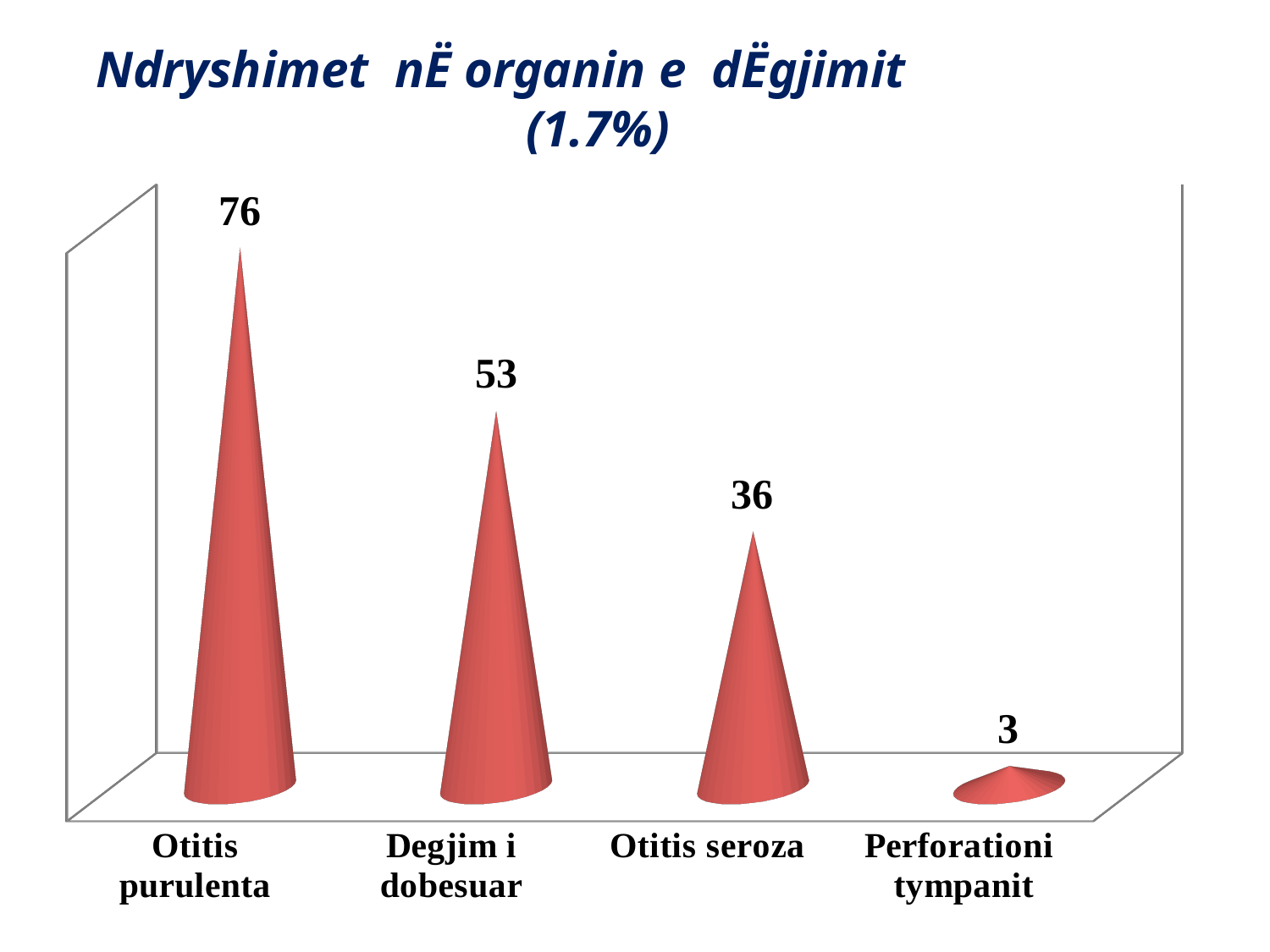
What is the difference between the values for Otitis seroza and Perforationi tympanit? 33 Do the values rise or fall from left to right across the categories? Fall What is the value for Perforationi tympanit? 3 What is the value for Otitis seroza? 36 What is the value for Otitis purulenta? 76 What kind of chart is shown on the slide? Bar chart What is the value for Degjim i dobesuar? 53 Which is larger, the value for Degjim i dobesuar or the value for Otitis seroza? Degjim i dobesuar Which category has the highest value? Otitis purulenta How many categories are shown on the chart? 4 Which category has the lowest value? Perforationi tympanit What is the difference between the values for Otitis purulenta and Degjim i dobesuar? 23